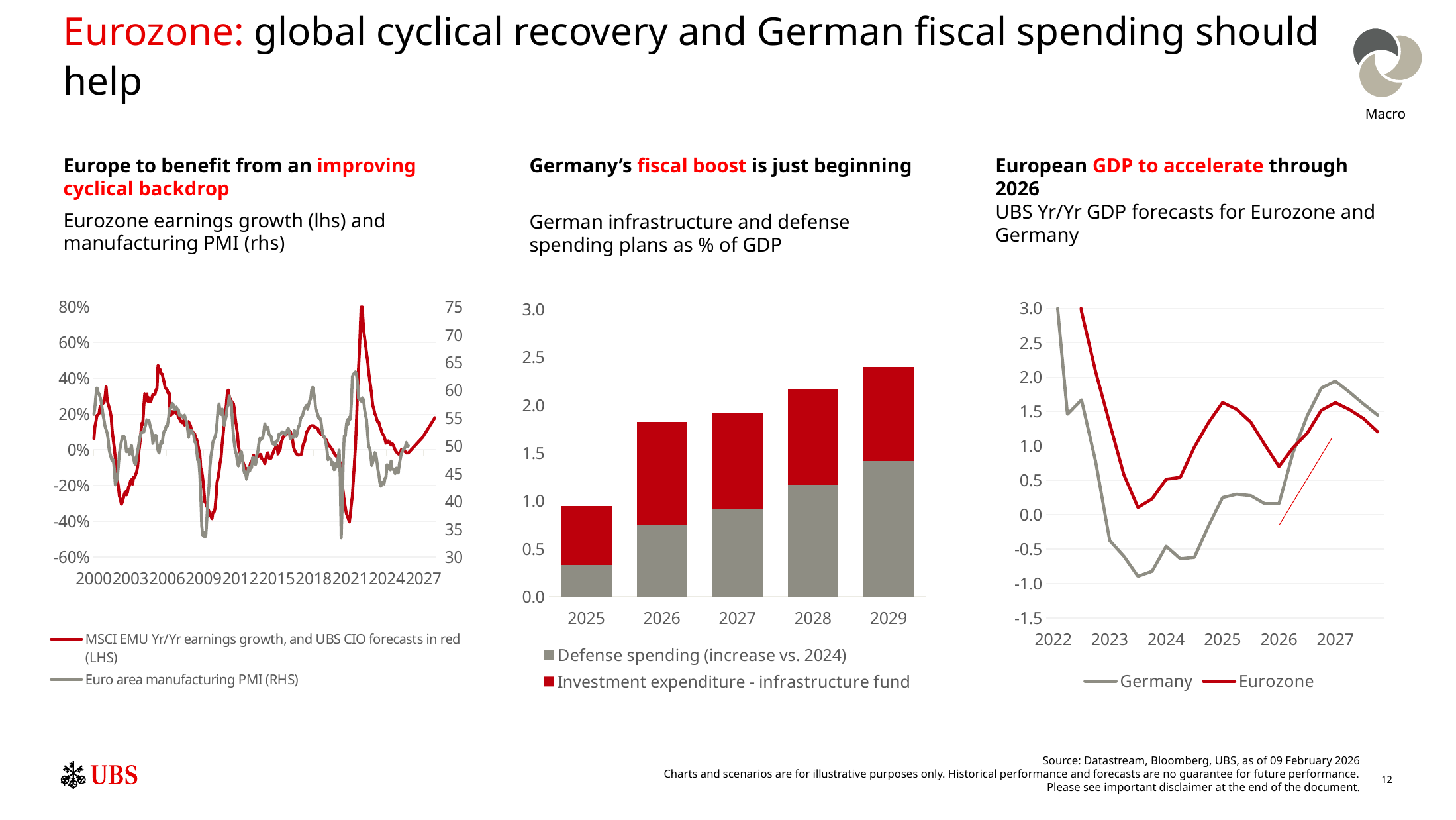
In the middle chart, 'German infrastructure and defense spending plans as % of GDP', is the total bar for 2029 greater or less than 2.0? greater What kind of chart is the middle chart, 'German infrastructure and defense spending plans as % of GDP'? bar chart In the middle chart, 'German infrastructure and defense spending plans as % of GDP', how many series does the legend list? 2 In the middle chart, 'German infrastructure and defense spending plans as % of GDP', which year has the lowest total bar? 2025 In the right-hand chart, 'UBS Yr/Yr GDP forecasts for Eurozone and Germany', is the Germany value in 2023 greater or less than 0.0? less What kind of chart is the right-hand chart, 'UBS Yr/Yr GDP forecasts for Eurozone and Germany'? line chart In the middle chart, 'German infrastructure and defense spending plans as % of GDP', do the total bars rise or fall from 2025 to 2029? rise In the middle chart, 'German infrastructure and defense spending plans as % of GDP', which colour represents 'Investment expenditure - infrastructure fund'? red In the middle chart, 'German infrastructure and defense spending plans as % of GDP', how many years are shown on the x axis? 5 In the middle chart, 'German infrastructure and defense spending plans as % of GDP', which year has the highest total bar? 2029 In the right-hand chart, 'UBS Yr/Yr GDP forecasts for Eurozone and Germany', how many series does the legend list? 2 In the left-hand chart, 'Eurozone earnings growth (lhs) and manufacturing PMI (rhs)', how many series does the legend list? 2